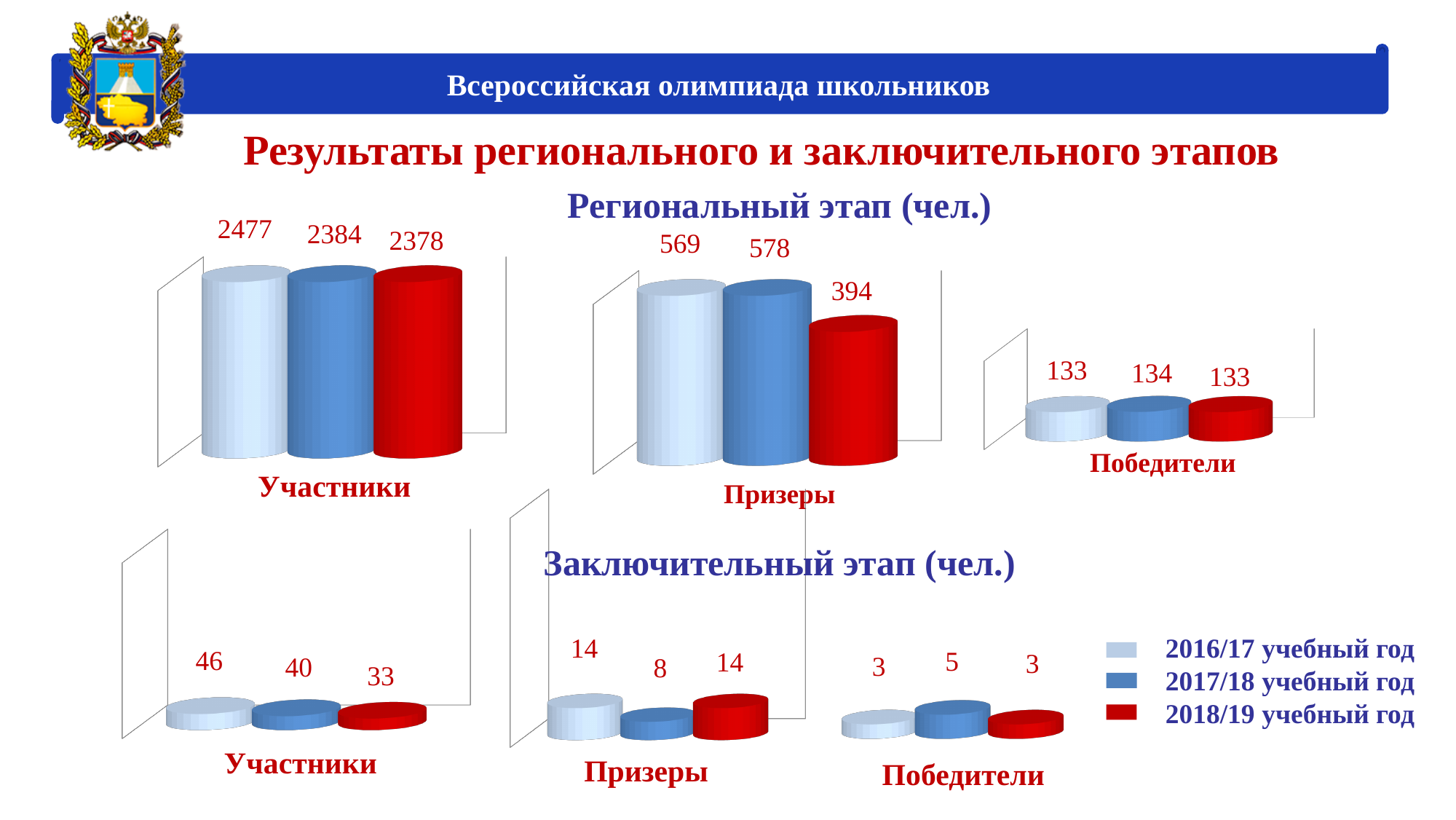
In the Заключительный этап section, which is larger for Победители: the 2017/18 value or the 2018/19 value? 2017/18 учебный год In the Региональный этап section, what is the value for Победители in the 2017/18 учебный год? 134 In the Региональный этап section, what is the value for Призеры in the 2018/19 учебный год? 394 How many series does the legend list? 3 In the Заключительный этап section, which year has the lowest value for Участники? 2018/19 учебный год In the Заключительный этап section, do the Участники values rise or fall from 2016/17 to 2018/19? fall In the Региональный этап section, which year has the highest value for Участники? 2016/17 учебный год What kind of chart is used for the Региональный этап Участники data? bar chart In the Заключительный этап section, what is the value for Призеры in the 2017/18 учебный год? 8 In the Региональный этап section, what is the value for Участники in the 2016/17 учебный год? 2477 In the Региональный этап section, what is the difference between the Призеры values for 2017/18 and 2018/19? 184 In the Заключительный этап section, what is the value for Участники in the 2018/19 учебный год? 33